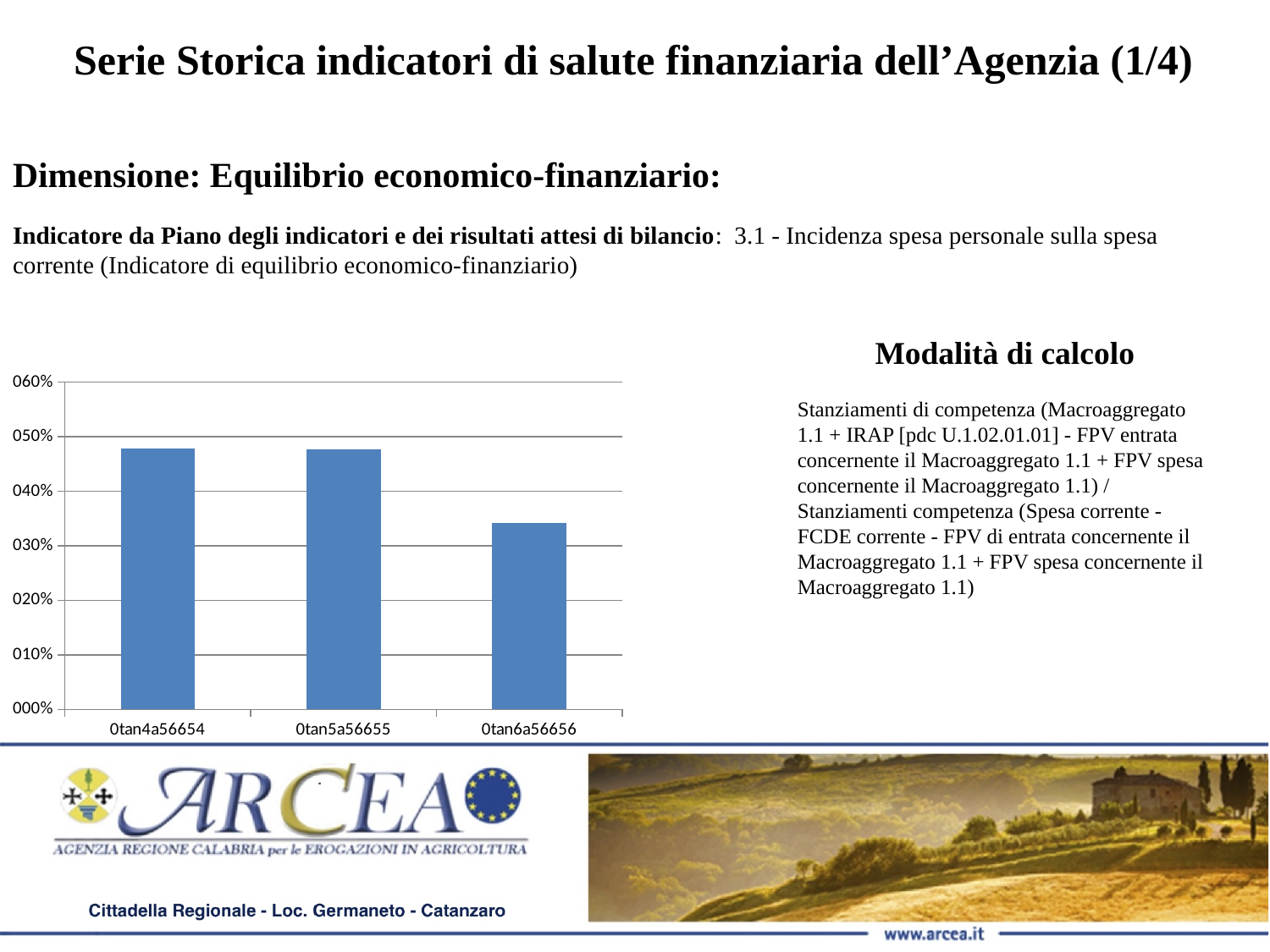
Is the value for 0tan5a56655 greater or less than 040%? greater How many bars (categories) does the chart show? 3 Is the value for 0tan4a56654 greater or less than 040%? greater Is the value for 0tan4a56654 greater or less than 050%? less Which is larger, the value for 0tan4a56654 or the value for 0tan6a56656? 0tan4a56654 Do the values rise or fall from the first category to the last along the x axis? fall What kind of chart is shown on the slide? bar chart Which is larger, the value for 0tan5a56655 or the value for 0tan6a56656? 0tan5a56655 What is the highest value shown on the chart's vertical axis? 060% Which category has the lowest value in the chart? 0tan6a56656